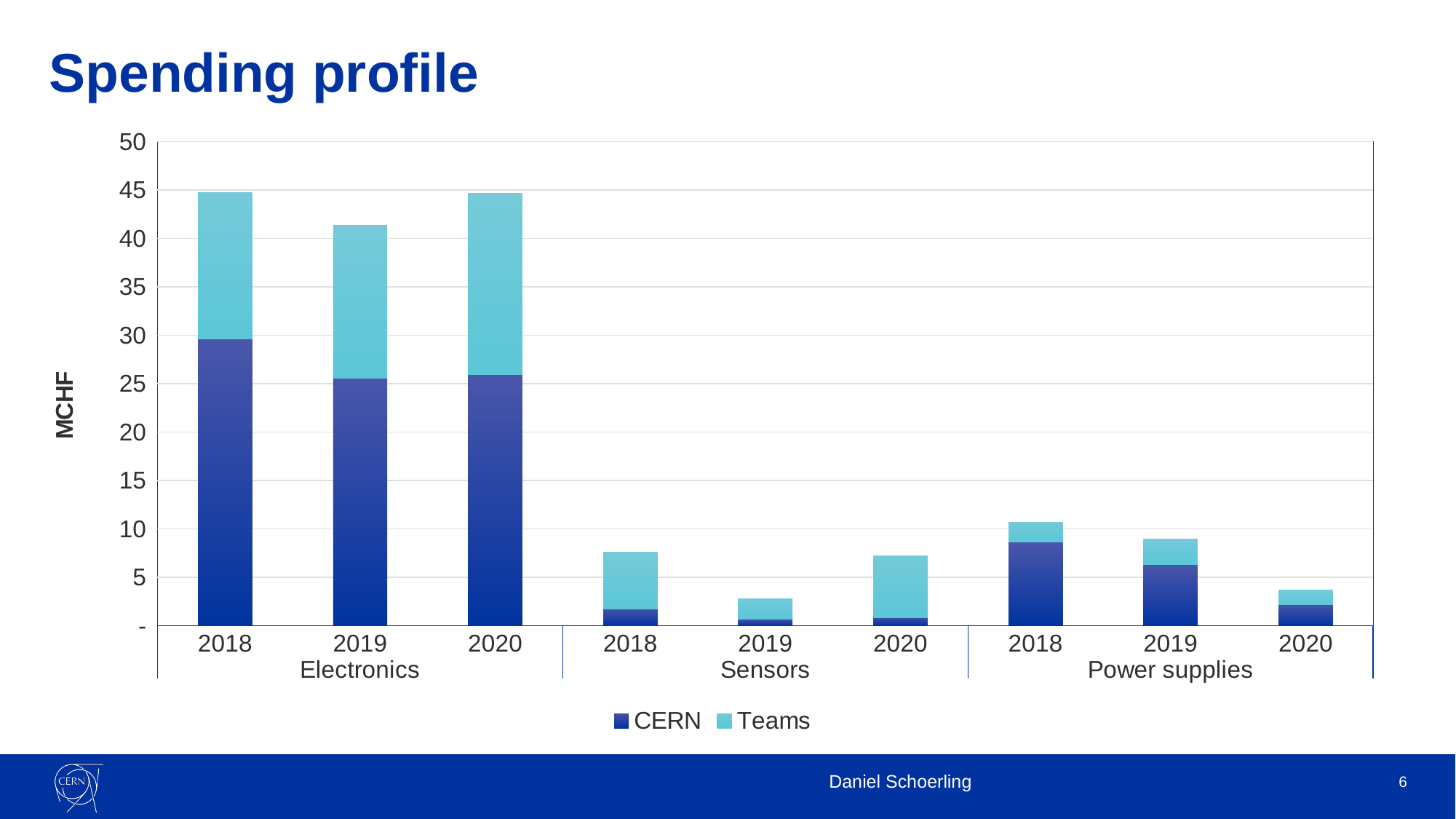
What kind of chart is shown on the slide? Stacked bar chart How many bars are plotted in the chart? 9 What is the label on the vertical axis? MCHF How many series does the legend list? 2 Do the Power supplies totals rise or fall from 2018 to 2020? fall Is the total value for Sensors in 2019 greater or less than 5? less Which year has the lowest total within the Power supplies group? 2020 Which year has the lowest total within the Sensors group? 2019 Is the total value for Power supplies in 2019 greater or less than 10? less What is the title of the chart? Spending profile Is the total value for Electronics in 2019 greater or less than 40? greater